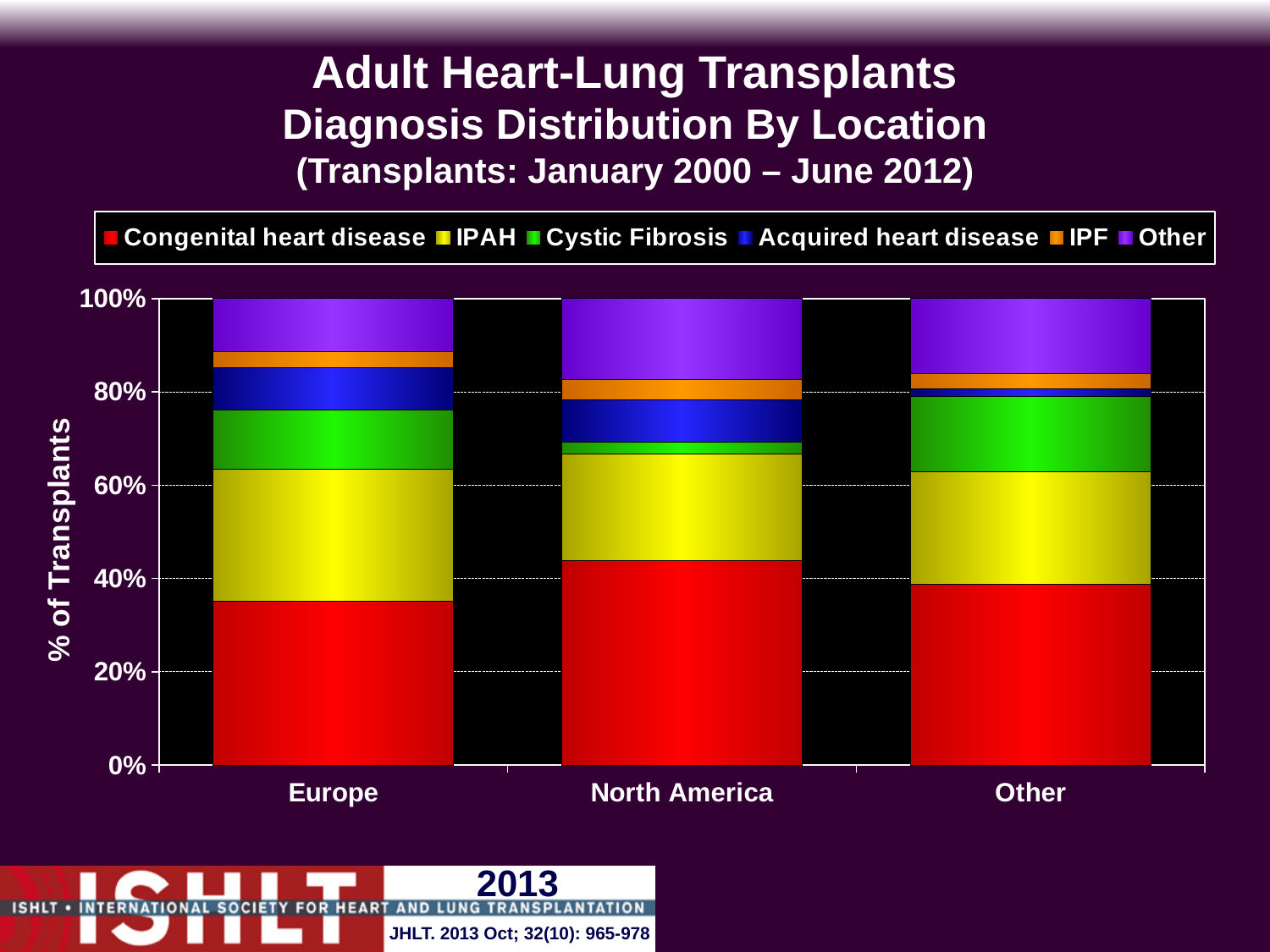
Which location has the largest Congenital heart disease share? North America What is the label on the y axis? % of Transplants How many locations are shown along the x axis? 3 Which has the larger Cystic Fibrosis share, North America or Other? Other Which location has the smallest Cystic Fibrosis share? North America Which diagnosis is shown in red in the legend? Congenital heart disease What is the total of the stacked bar for Europe? 100% What kind of chart is shown on the slide? Stacked bar chart Is the Congenital heart disease share for Europe greater or less than 40%? less Which has the larger Congenital heart disease share, Europe or North America? North America How many diagnosis series does the legend list? 6 Is the Congenital heart disease share for North America greater or less than 40%? greater